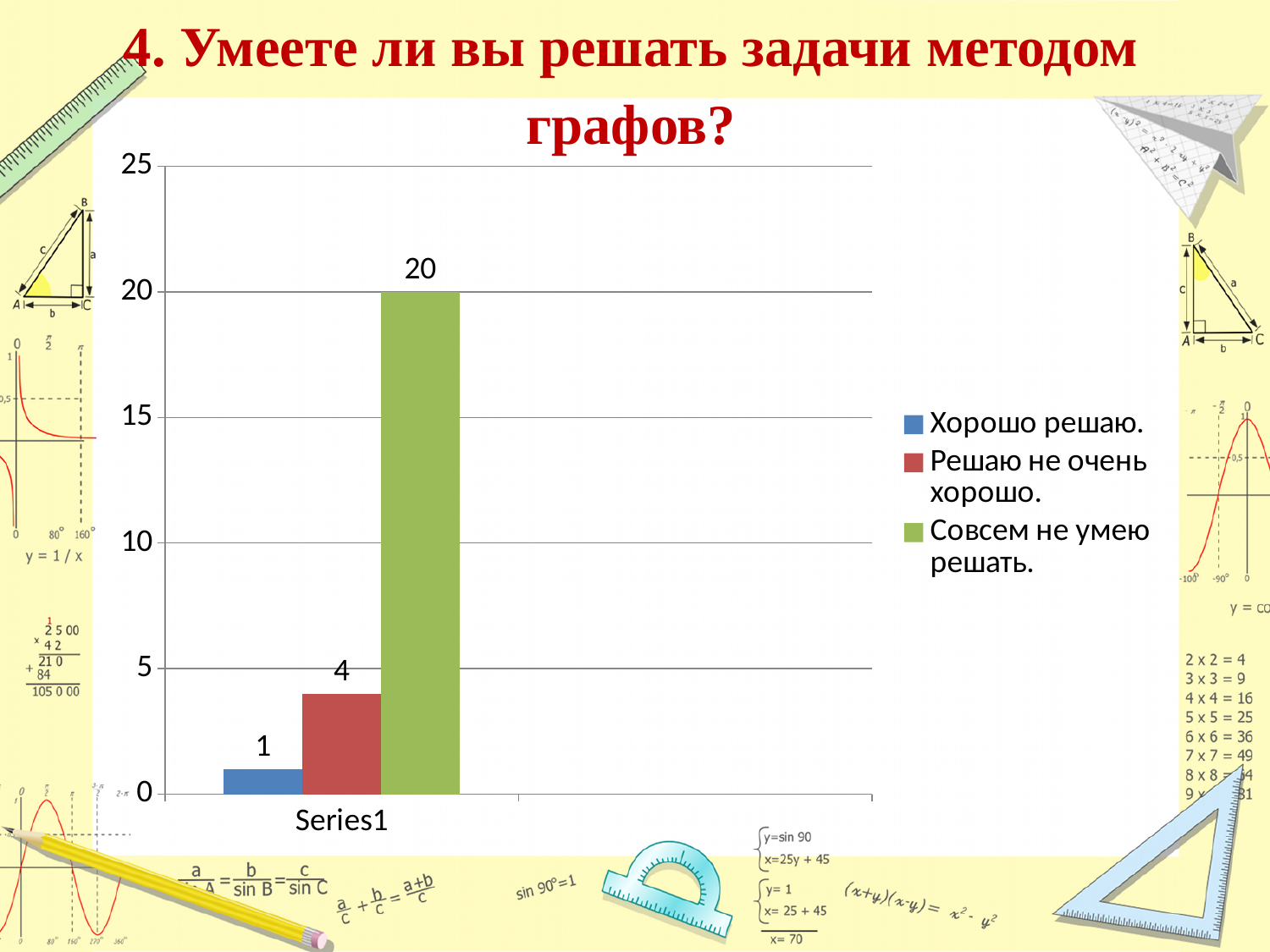
What value is shown for "Хорошо решаю."? 1 Which legend entry has the highest value? Совсем не умею решать. What is the difference between the values for "Решаю не очень хорошо." and "Хорошо решаю."? 3 Is the value for "Совсем не умею решать." greater or less than 15? greater Which legend entry has the lowest value? Хорошо решаю. How many series does the legend list? 3 What colour is the bar for "Совсем не умею решать."? green What is the difference between the values for "Совсем не умею решать." and "Решаю не очень хорошо."? 16 Which is larger: the value for "Решаю не очень хорошо." or the value for "Хорошо решаю."? Решаю не очень хорошо. What value is shown for "Решаю не очень хорошо."? 4 What kind of chart is shown on the slide? bar chart What value is shown for "Совсем не умею решать."? 20